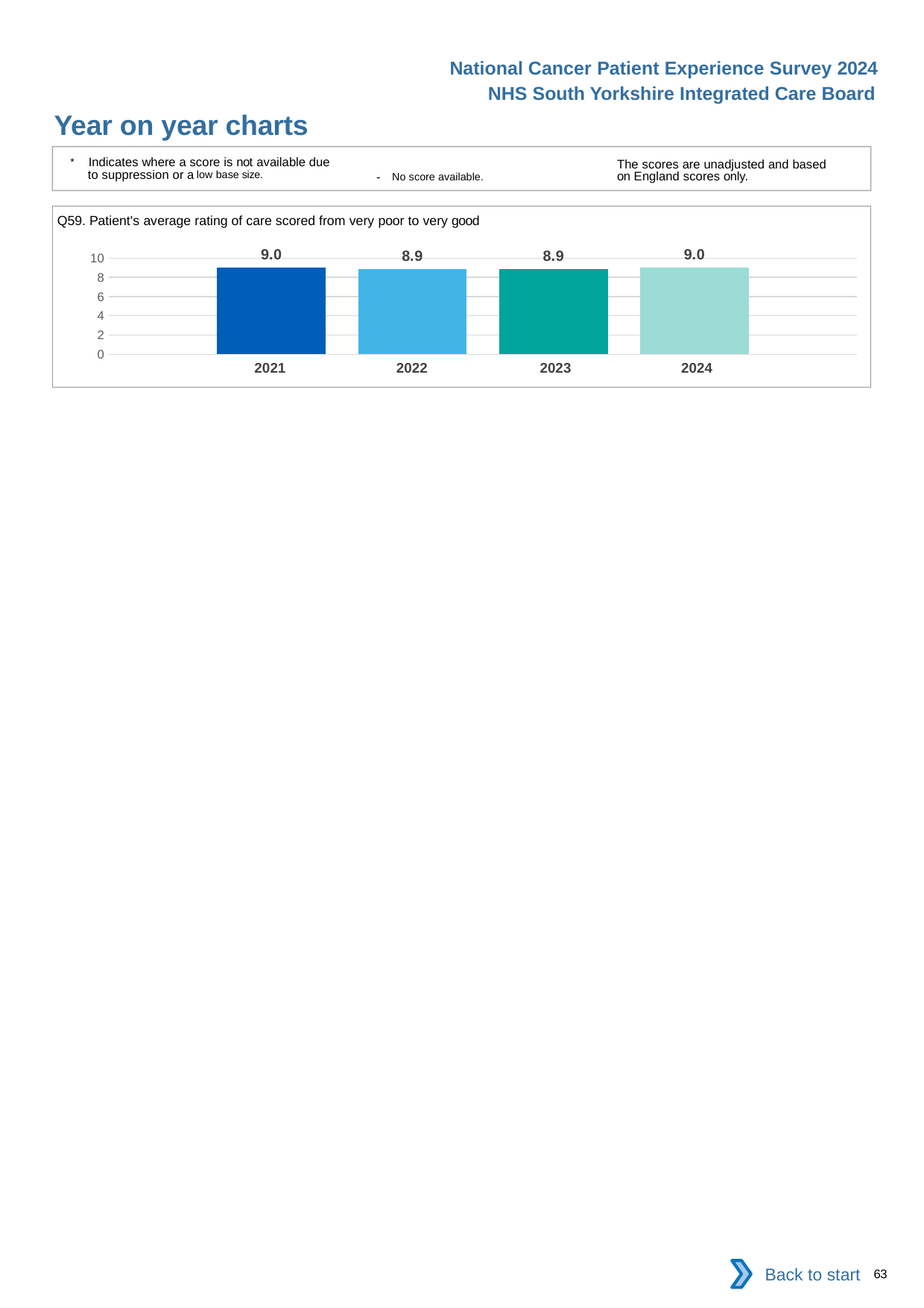
What is the value for 2023? 8.9 What is the value for 2022? 8.9 What is the value for 2021? 9.0 How many years are shown on the chart? 4 What is the difference between the values for 2024 and 2023? 0.1 What is the title of the chart? Q59. Patient's average rating of care scored from very poor to very good What is the value for 2024? 9.0 What is the difference between the values for 2021 and 2022? 0.1 Which is larger, the value for 2023 or the value for 2024? 2024 What kind of chart is shown on the slide? bar chart Is the value for 2023 greater or less than 8? greater Which is larger, the value for 2021 or the value for 2022? 2021